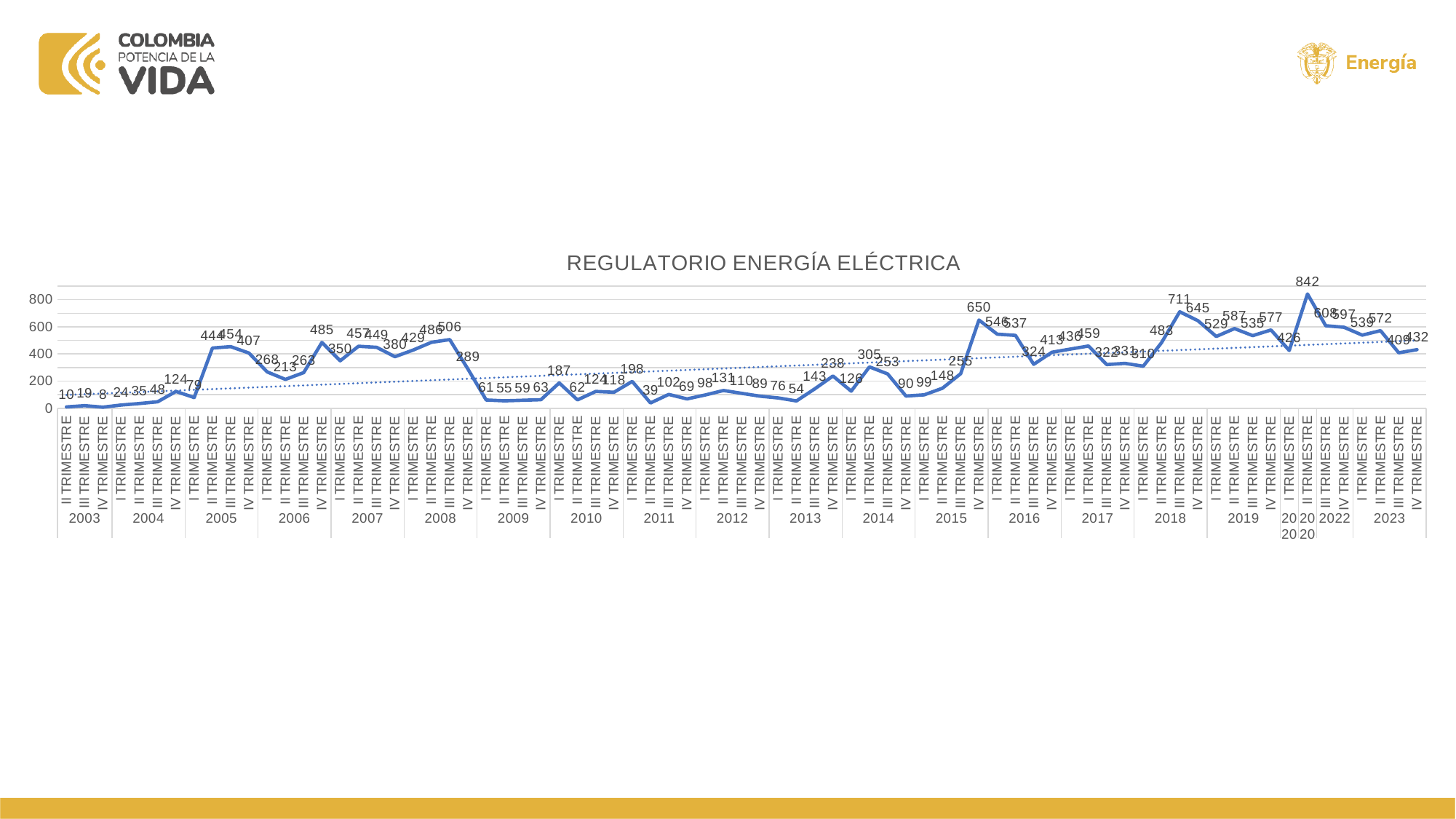
What is the value for III TRIMESTRE 2018? 711 What is the difference between the values for IV TRIMESTRE 2015 and III TRIMESTRE 2015? 395 What is the title of the chart? REGULATORIO ENERGÍA ELÉCTRICA What is the highest value plotted on the chart? 842 What is the lowest value plotted on the chart? 8 What is the value for IV TRIMESTRE 2015? 650 Is the value for IV TRIMESTRE 2008 greater or less than 400? less What is the value for IV TRIMESTRE 2004? 124 What is the difference between the values for III TRIMESTRE 2018 and IV TRIMESTRE 2018? 66 Which is larger, the value for II TRIMESTRE 2005 or the value for IV TRIMESTRE 2006? IV TRIMESTRE 2006 What kind of chart is shown on the slide? line chart What is the value for I TRIMESTRE 2011? 198